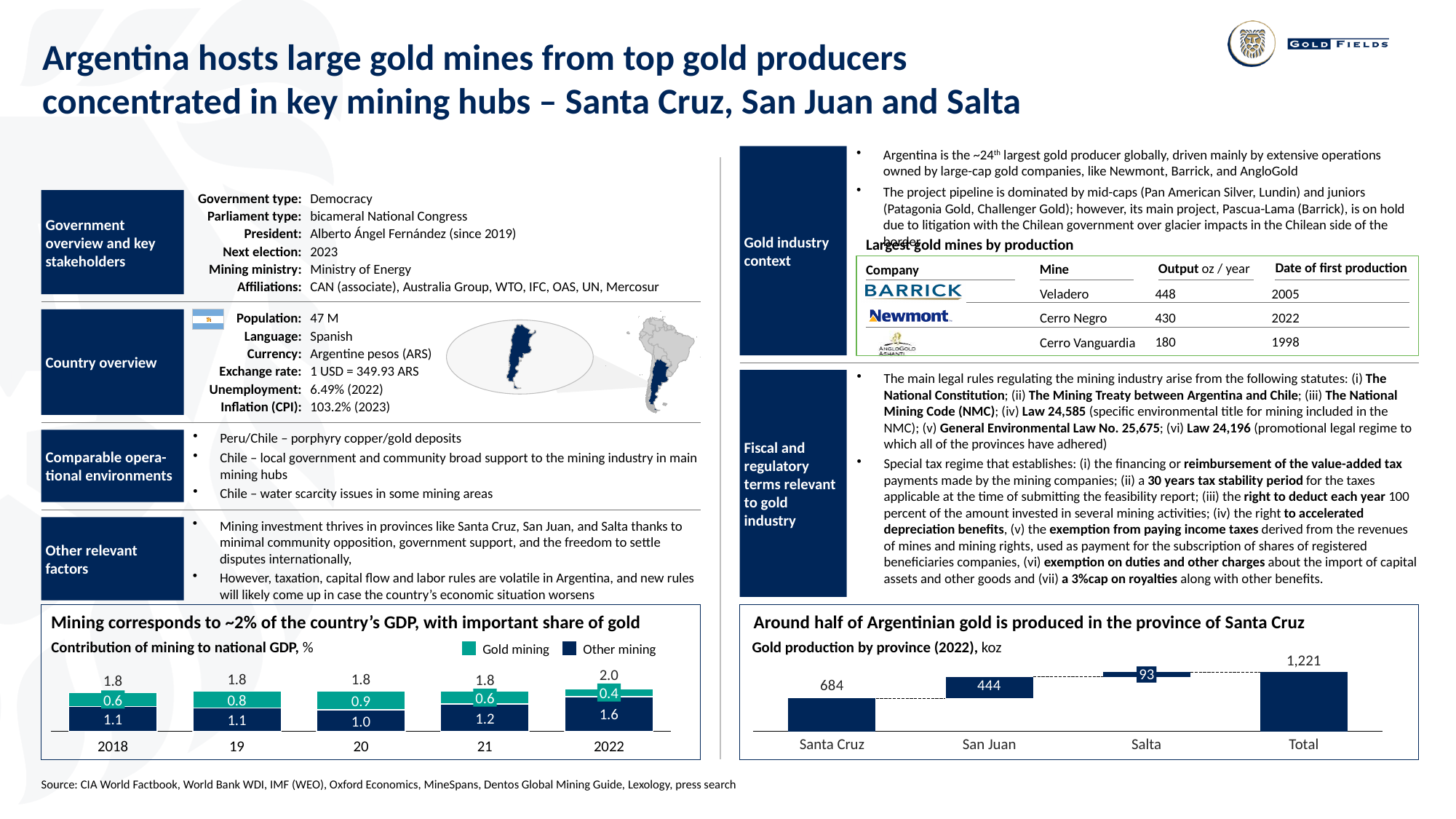
In the 'Contribution of mining to national GDP' chart, what is the total contribution of mining shown for 2022? 2.0 In the 'Contribution of mining to national GDP' chart, which year has the highest Gold mining value? 20 In the 'Contribution of mining to national GDP' chart, which year has the lowest Gold mining value? 2022 In the 'Contribution of mining to national GDP' chart, what is the difference between the Other mining values for 2022 and 2018? 0.5 In the 'Gold production by province (2022)' chart, which province has the lowest gold production? Salta In the 'Contribution of mining to national GDP' chart, what is the Gold mining value for 2019? 0.8 What kind of chart is the 'Contribution of mining to national GDP' chart? Stacked bar chart In the 'Gold production by province (2022)' chart, what is the difference between Santa Cruz and San Juan? 240 In the 'Gold production by province (2022)' chart, what is the value for Santa Cruz? 684 In the 'Contribution of mining to national GDP' chart, what is the Other mining value for 2022? 1.6 In the 'Contribution of mining to national GDP' chart, how many years are shown on the x axis? 5 In the 'Contribution of mining to national GDP' chart, how many series does the legend list? 2